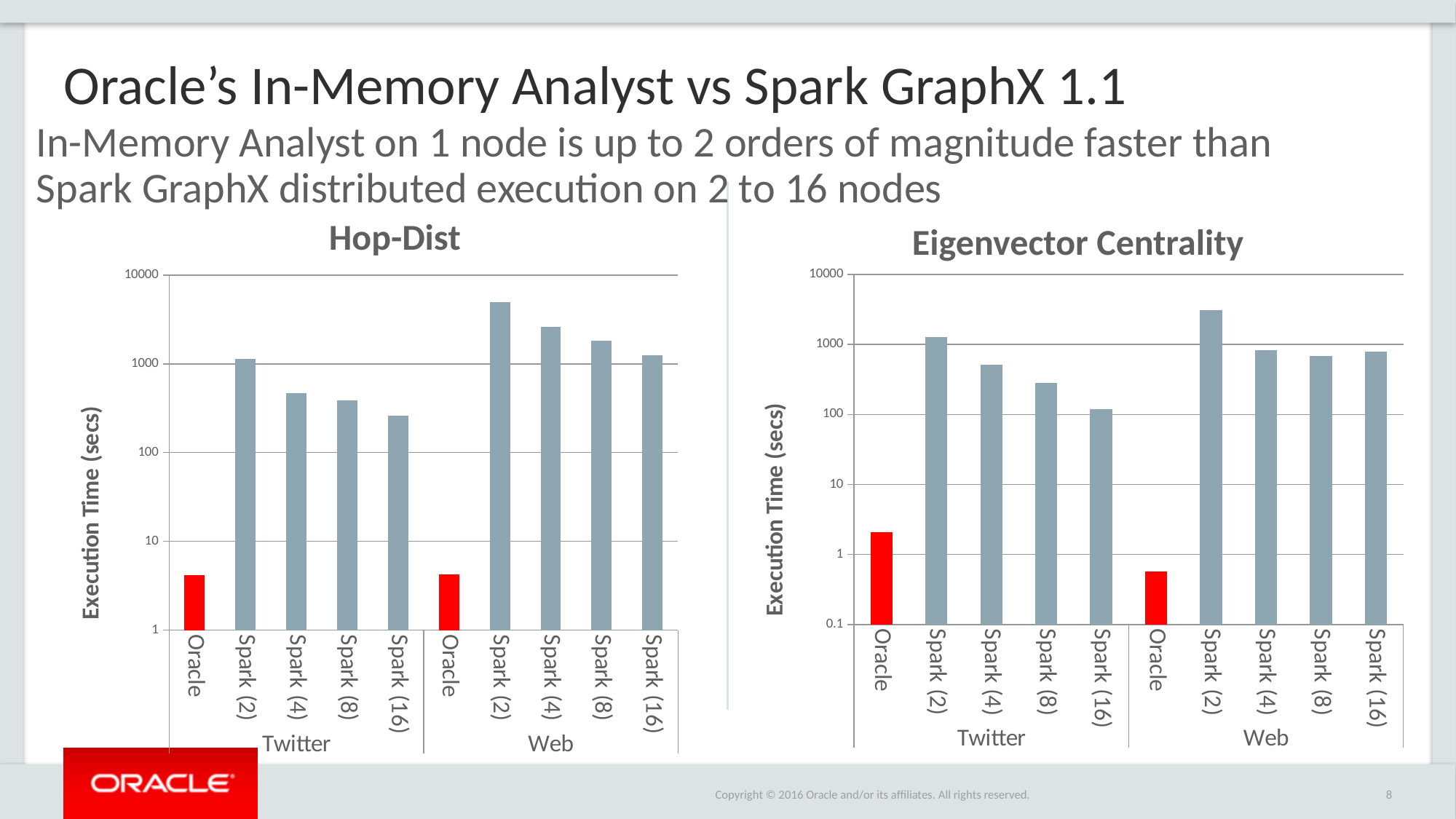
In the Hop-Dist chart, is the value for Spark (16) under Twitter greater or less than 1000? less What kind of chart is the Hop-Dist chart? bar chart In the Hop-Dist chart, which bar has the highest execution time? Spark (2) under Web In the Eigenvector Centrality chart, which is larger: Spark (2) under Twitter or Spark (2) under Web? Spark (2) under Web In the Hop-Dist chart, is the value for Spark (2) under Web greater or less than 1000? greater In the Hop-Dist chart, how many bars are plotted in total? 10 In the Eigenvector Centrality chart, is the value for Oracle under Twitter greater or less than 1? greater In the Hop-Dist chart, which is larger for Twitter: Spark (2) or Spark (16)? Spark (2) In the Eigenvector Centrality chart, which bar has the lowest execution time? Oracle under Web In the Hop-Dist chart, do the Spark bars for Twitter rise or fall from Spark (2) to Spark (16)? fall What is the y-axis title of the Eigenvector Centrality chart? Execution Time (secs)